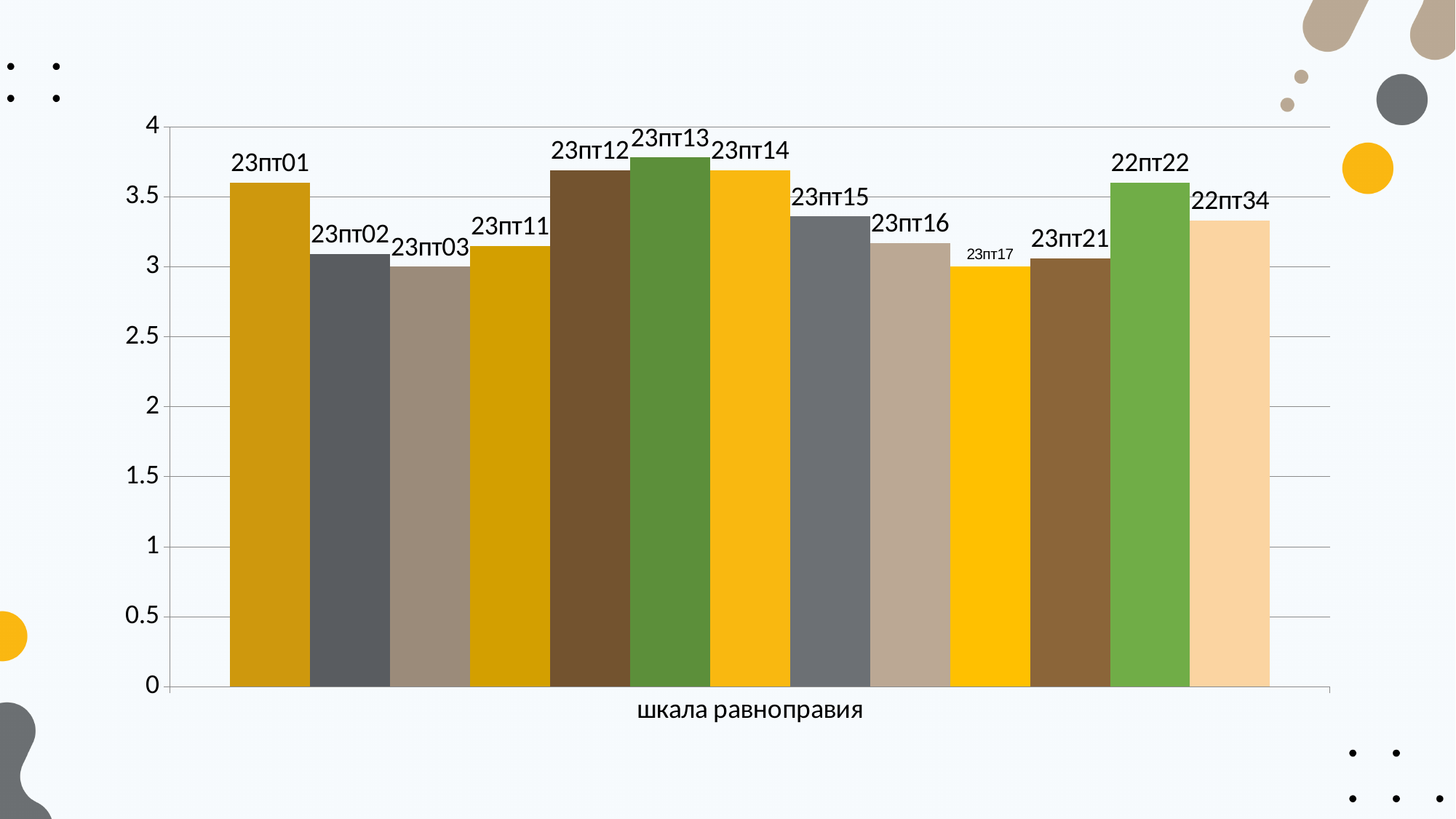
Which is larger, the value for 23пт15 or the value for 23пт16? 23пт15 Which bar is the highest in the chart? 23пт13 What kind of chart is shown on the slide? bar chart Which is larger, the value for 22пт22 or the value for 22пт34? 22пт22 Is the value for 23пт15 greater or less than 3.5? less Is the value for 23пт12 greater or less than 3.5? greater Is the value for 23пт01 greater or less than 3.5? greater How many bars are plotted in the chart? 13 What label is shown on the horizontal axis of the chart? шкала равноправия Which is larger, the value for 23пт13 or the value for 23пт02? 23пт13